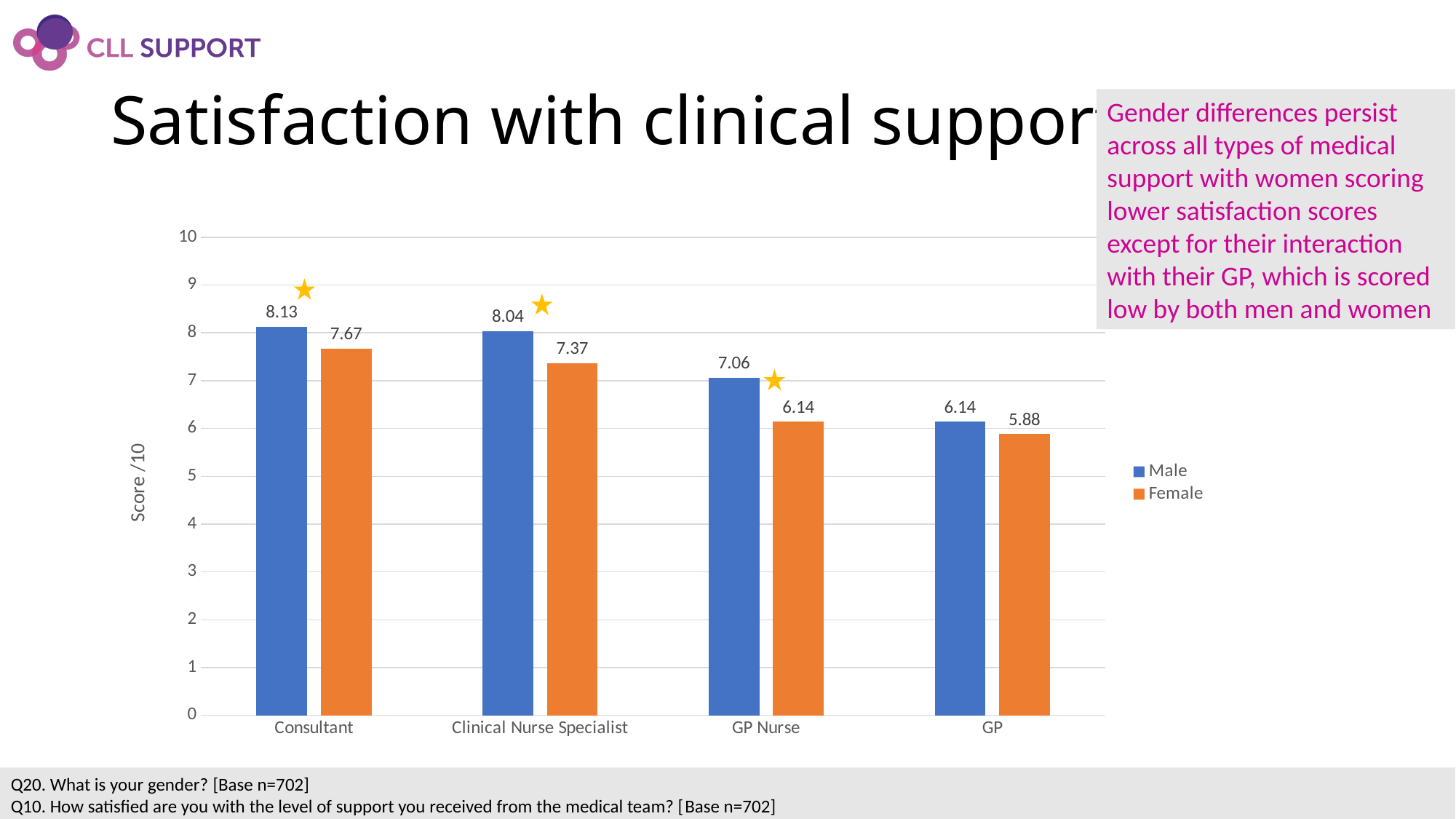
How many series does the legend list? 2 What is the difference between the Male and Female scores for GP Nurse? 0.92 Which is larger, the Male score for Clinical Nurse Specialist or the Female score for Consultant? Male score for Clinical Nurse Specialist What is the Female score for Clinical Nurse Specialist? 7.37 What is the Male satisfaction score for Consultant? 8.13 What is the difference between the Male and Female scores for GP? 0.26 What kind of chart is shown on the slide? Bar chart Which category has the highest Male score? Consultant What is the label on the vertical axis? Score /10 What is the Female satisfaction score for GP Nurse? 6.14 How many categories are shown on the x axis? 4 Which category has the lowest Female score? GP